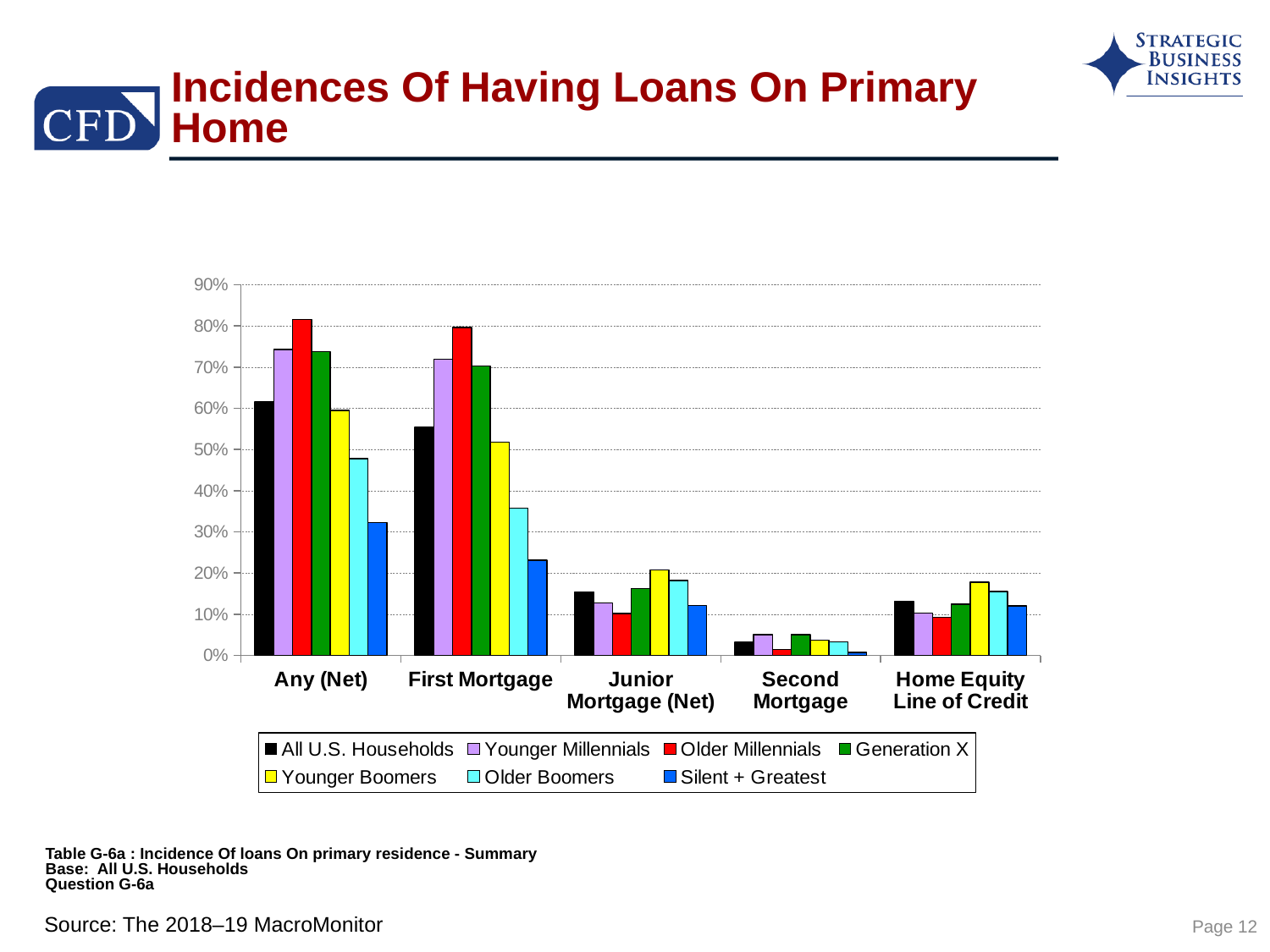
For Junior Mortgage (Net), which is larger: Younger Boomers or Older Millennials? Younger Boomers Is the value for All U.S. Households in Any (Net) greater or less than 50%? greater What kind of chart is shown on the slide? bar chart Which series has the lowest value for First Mortgage? Silent + Greatest Is the value for Silent + Greatest in Any (Net) greater or less than 40%? less Which loan category has the lowest values across all series? Second Mortgage Is the value for Older Boomers in First Mortgage greater or less than 40%? less How many series does the legend list? 7 How many loan categories are shown along the x axis? 5 Which series has the highest value for Any (Net)? Older Millennials What colour represents Older Millennials in the legend? red